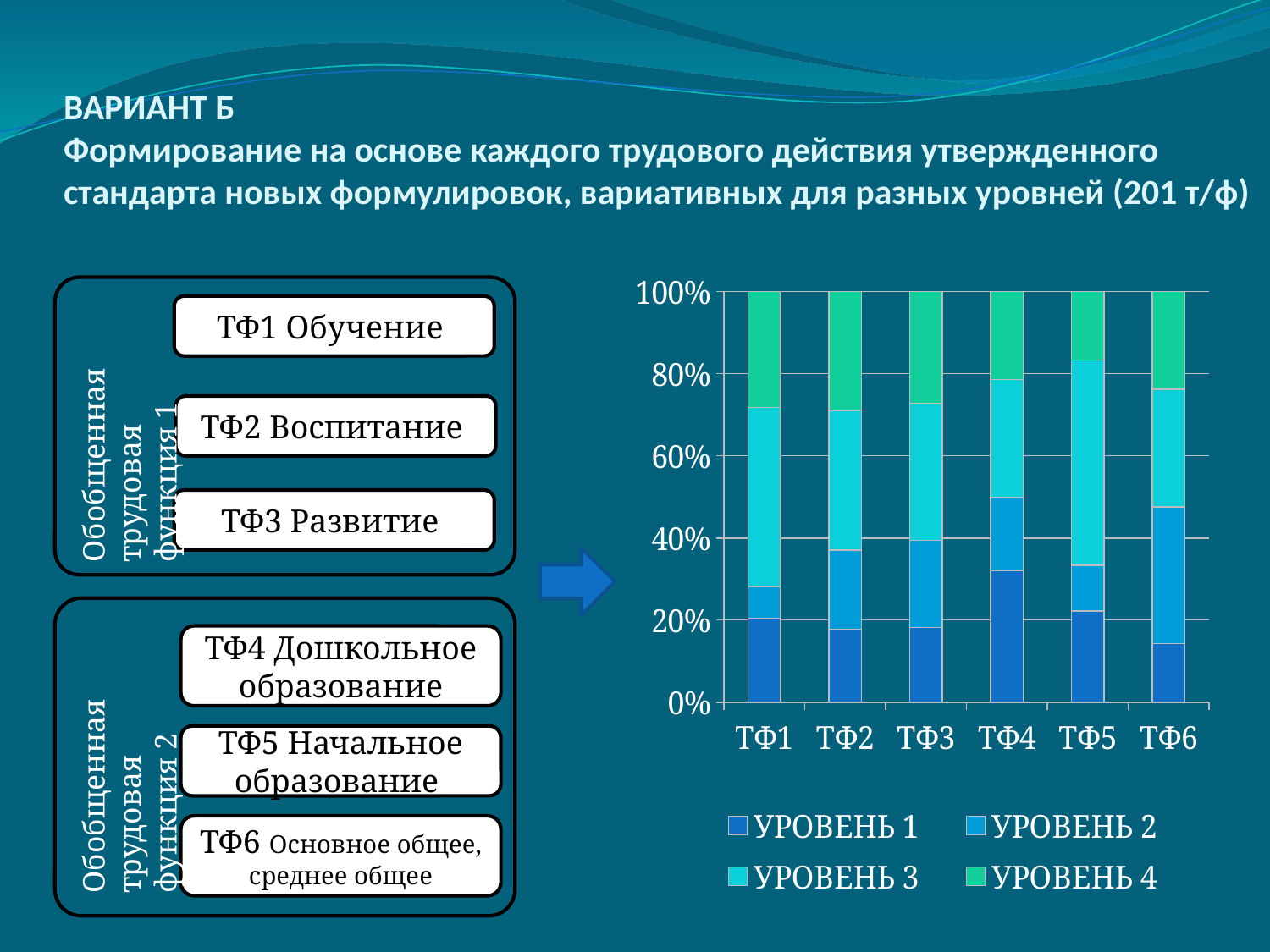
What kind of chart is shown on the slide? stacked bar chart Which has the larger УРОВЕНЬ 1 segment, ТФ4 or ТФ6? ТФ4 Is the УРОВЕНЬ 1 value for ТФ6 greater or less than 20%? less What are the names of the series listed in the chart legend? УРОВЕНЬ 1, УРОВЕНЬ 2, УРОВЕНЬ 3, УРОВЕНЬ 4 How many series does the chart legend list? 4 How many categories are shown on the x axis of the chart? 6 Is the УРОВЕНЬ 1 value for ТФ4 greater or less than 20%? greater Which category has the smallest УРОВЕНЬ 4 segment? ТФ5 What is the label of the first category on the x axis? ТФ1 What total does each stacked bar in the chart reach? 100% Which category has the largest УРОВЕНЬ 1 segment? ТФ4 Which category has the largest УРОВЕНЬ 2 segment? ТФ6